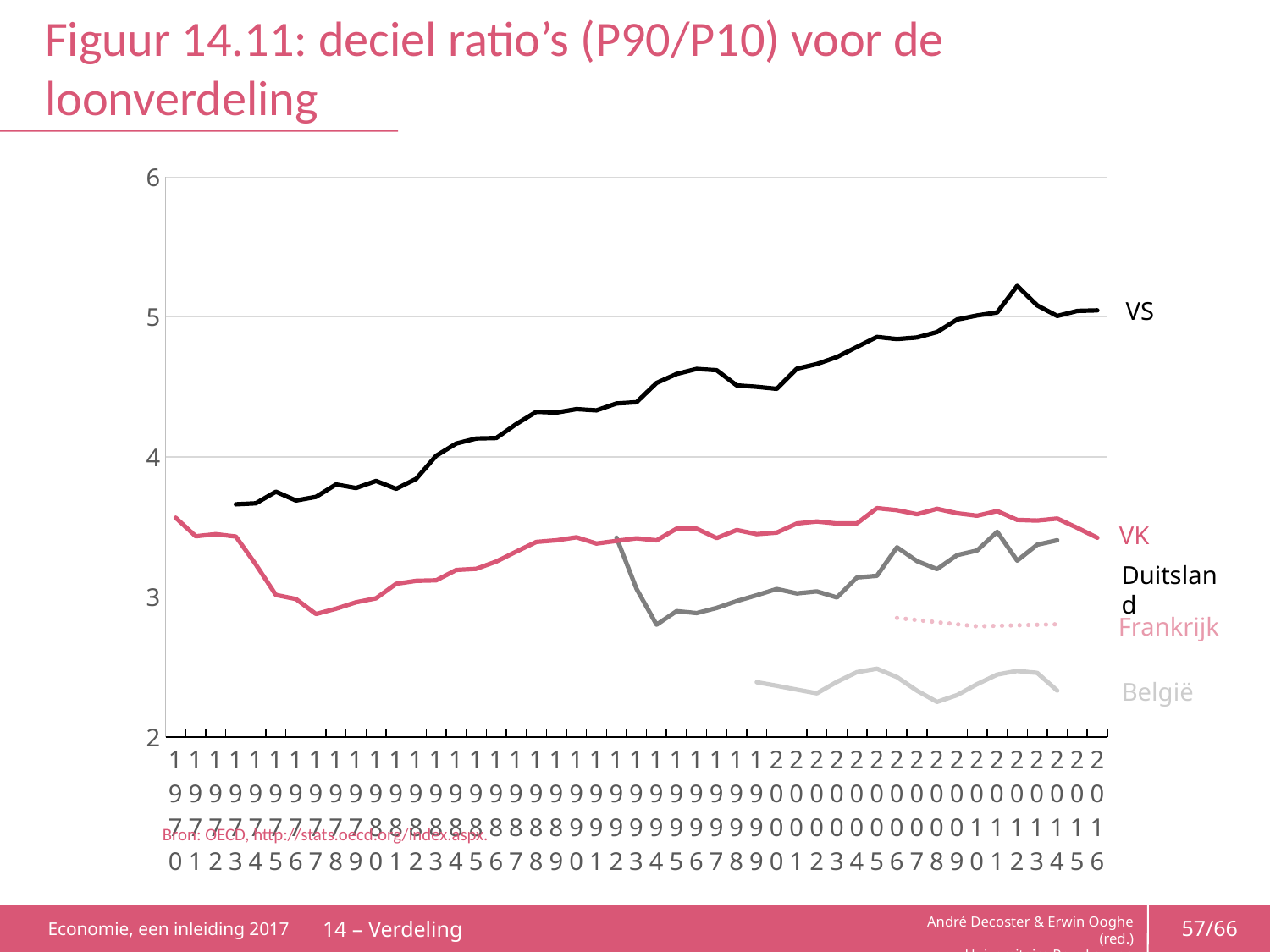
What kind of chart is shown on the slide? line chart What is the first year shown on the x axis? 1970 Which is larger in 2014, the value for Duitsland or the value for Frankrijk? Duitsland Is the value for Duitsland in 1992 greater or less than 3? greater Which country has the lowest deciel ratio in the chart? België Which is larger in 2016, the value for VS or the value for VK? VS Which country has the highest deciel ratio in 2016? VS Does the deciel ratio for VS rise or fall over the period shown? rise Is the value for VS in 2016 greater or less than 4? greater Which country's series is drawn as a dotted line? Frankrijk Is the value for België in 2010 greater or less than 3? less How many countries (series) are plotted in the chart? 5